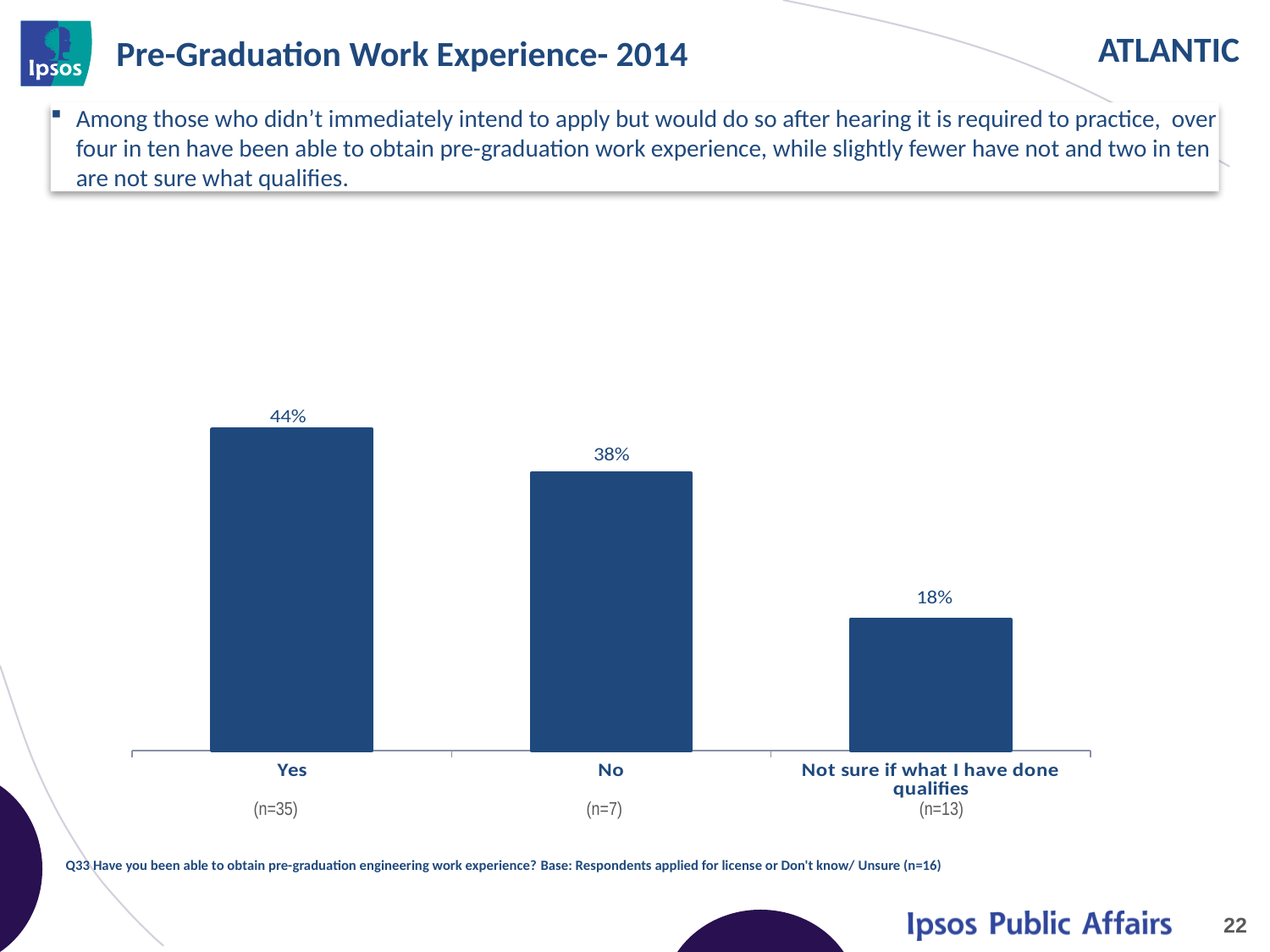
How many categories are shown in the chart? 3 What is the difference between the 'No' value and the 'Not sure if what I have done qualifies' value? 20% What kind of chart is shown on the slide? Bar chart Which category has the lowest value? Not sure if what I have done qualifies Do the values rise or fall from left to right across the categories? Fall What is the value for the 'Yes' category? 44% Which category has the highest value? Yes What is the sample size (n) shown under the 'Yes' category? (n=35) What is the value for 'Not sure if what I have done qualifies'? 18% What is the difference between the 'Yes' and 'No' values? 6% What is the value for the 'No' category? 38% Which is larger, the value for 'Yes' or the value for 'No'? Yes